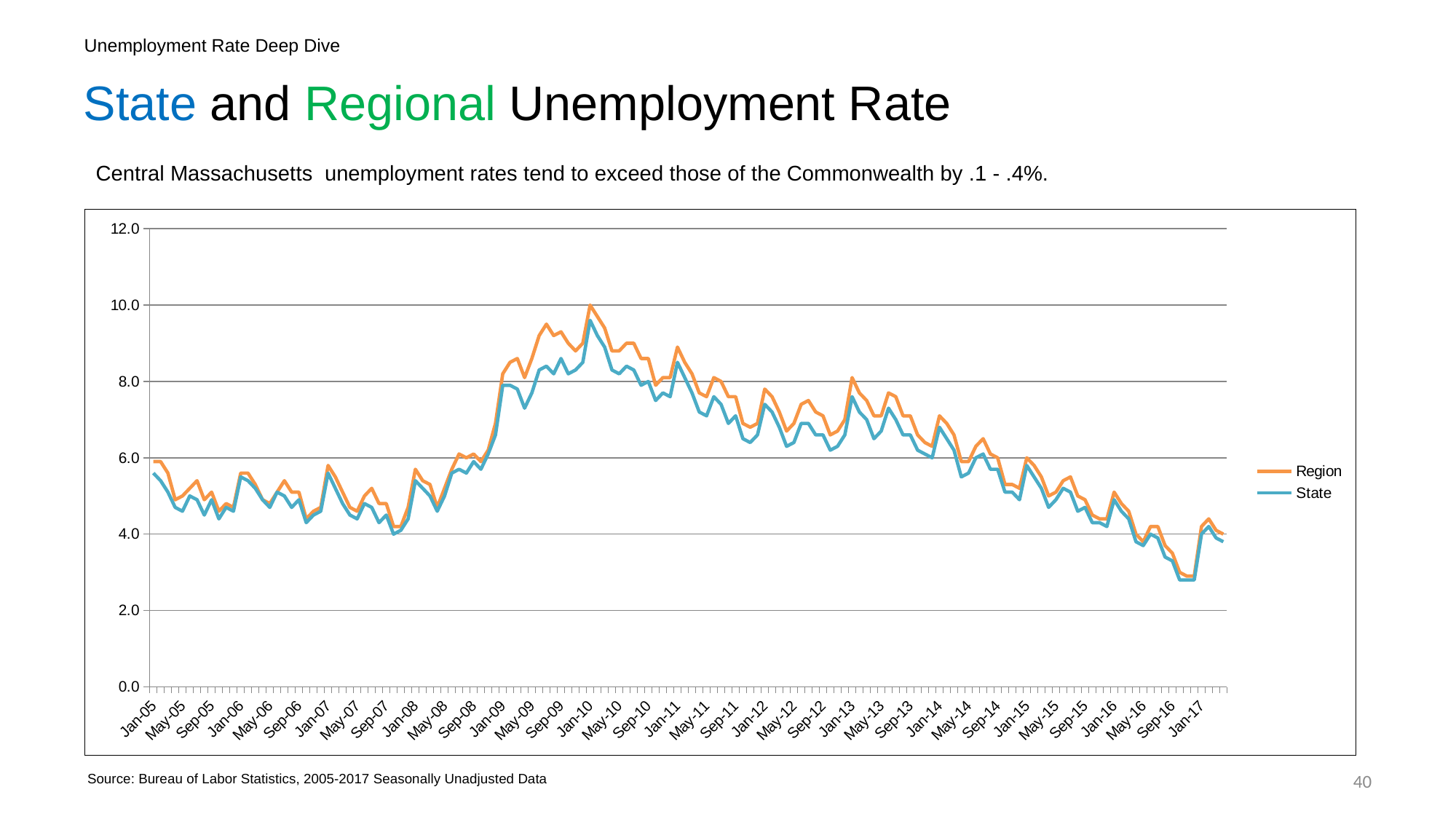
Is the value for State at Jan-05 greater or less than 6.0? less Is the value for Region at Jan-10 greater or less than 8.0? greater How many series does the legend list? 2 Is the value for State at Sep-16 greater or less than 4.0? less What are the two series named in the legend? Region and State Which series reaches the highest peak on the chart? Region At Jan-10, which series has the higher value, Region or State? Region Do the values rise or fall overall from Jan-10 to Jan-17? fall What kind of chart is shown on the slide? line chart Which colour is used for the Region series? orange